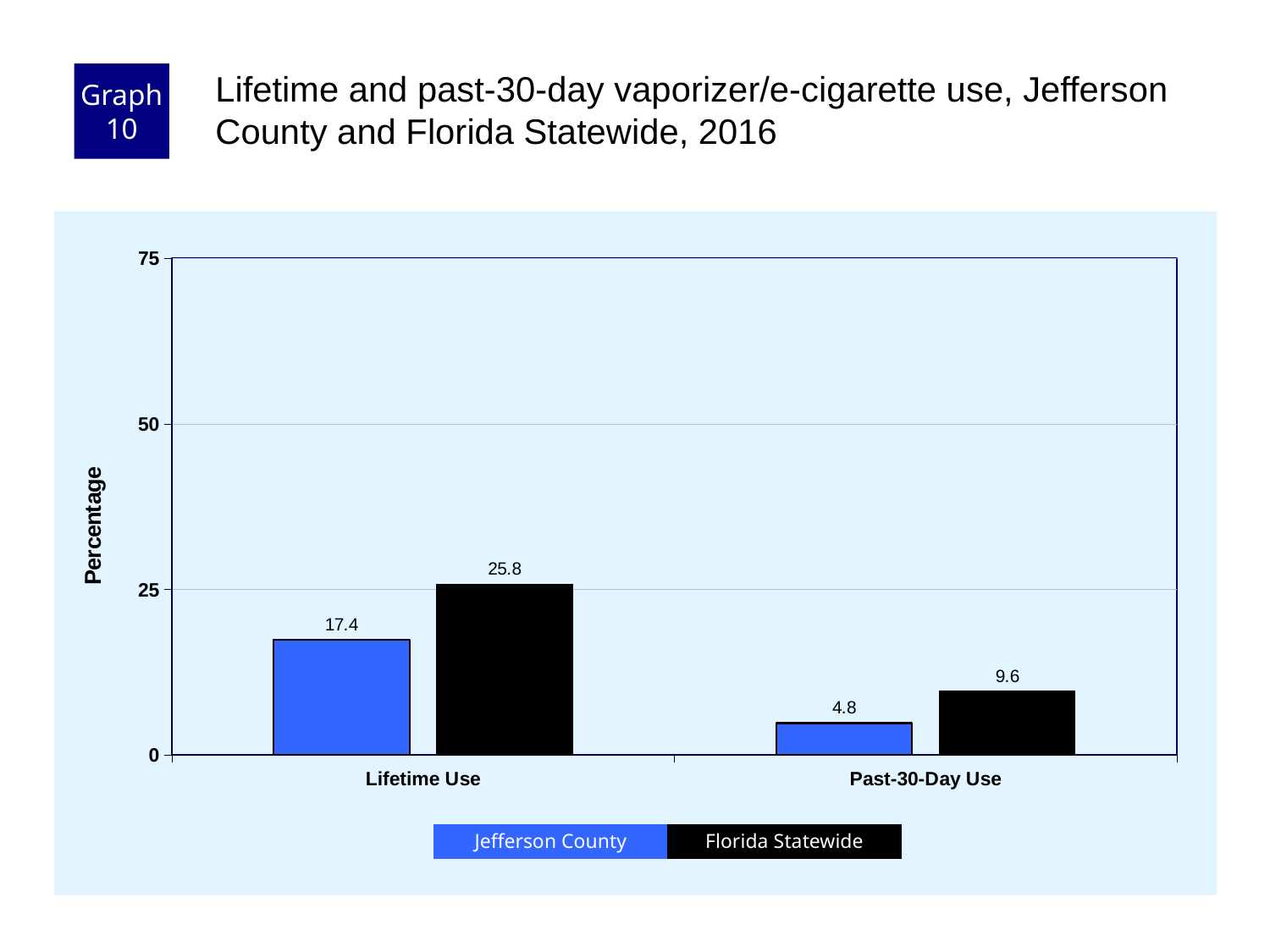
What is the Florida Statewide value for Past-30-Day Use? 9.6 What is the difference between the Florida Statewide and Jefferson County values for Past-30-Day Use? 4.8 How many categories are shown on the x axis? 2 Is the Florida Statewide value for Lifetime Use greater or less than 25? greater Which bar has the lowest value on the chart? Jefferson County, Past-30-Day Use Which bar has the highest value on the chart? Florida Statewide, Lifetime Use How many series does the legend list? 2 Which is larger for Past-30-Day Use, Jefferson County or Florida Statewide? Florida Statewide What is the Jefferson County value for Past-30-Day Use? 4.8 What kind of chart is shown on the slide? bar chart What is the Jefferson County value for Lifetime Use? 17.4 What is the difference between the Florida Statewide and Jefferson County values for Lifetime Use? 8.4